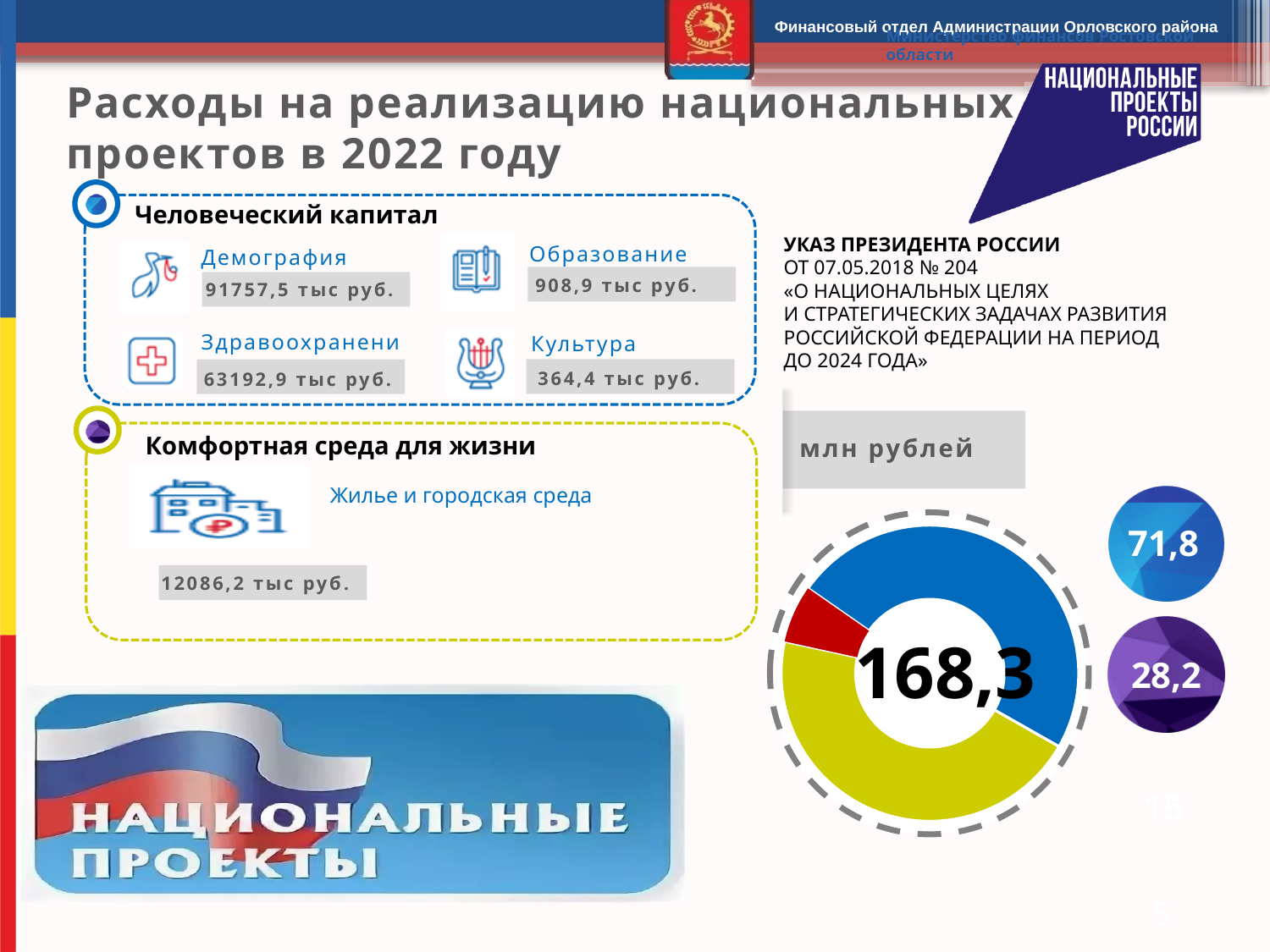
How many slices does the donut chart on the right have? 3 What value is printed in the centre of the donut chart? 168,3 In the donut chart, which slice is larger, the red one or the yellow one? yellow What kind of chart is shown on the right side of the slide? pie chart (donut) In the donut chart, which slice is larger, the red one or the blue one? blue Which colour slice of the donut chart is the smallest? red What unit label is shown in the grey box above the donut chart? млн рублей